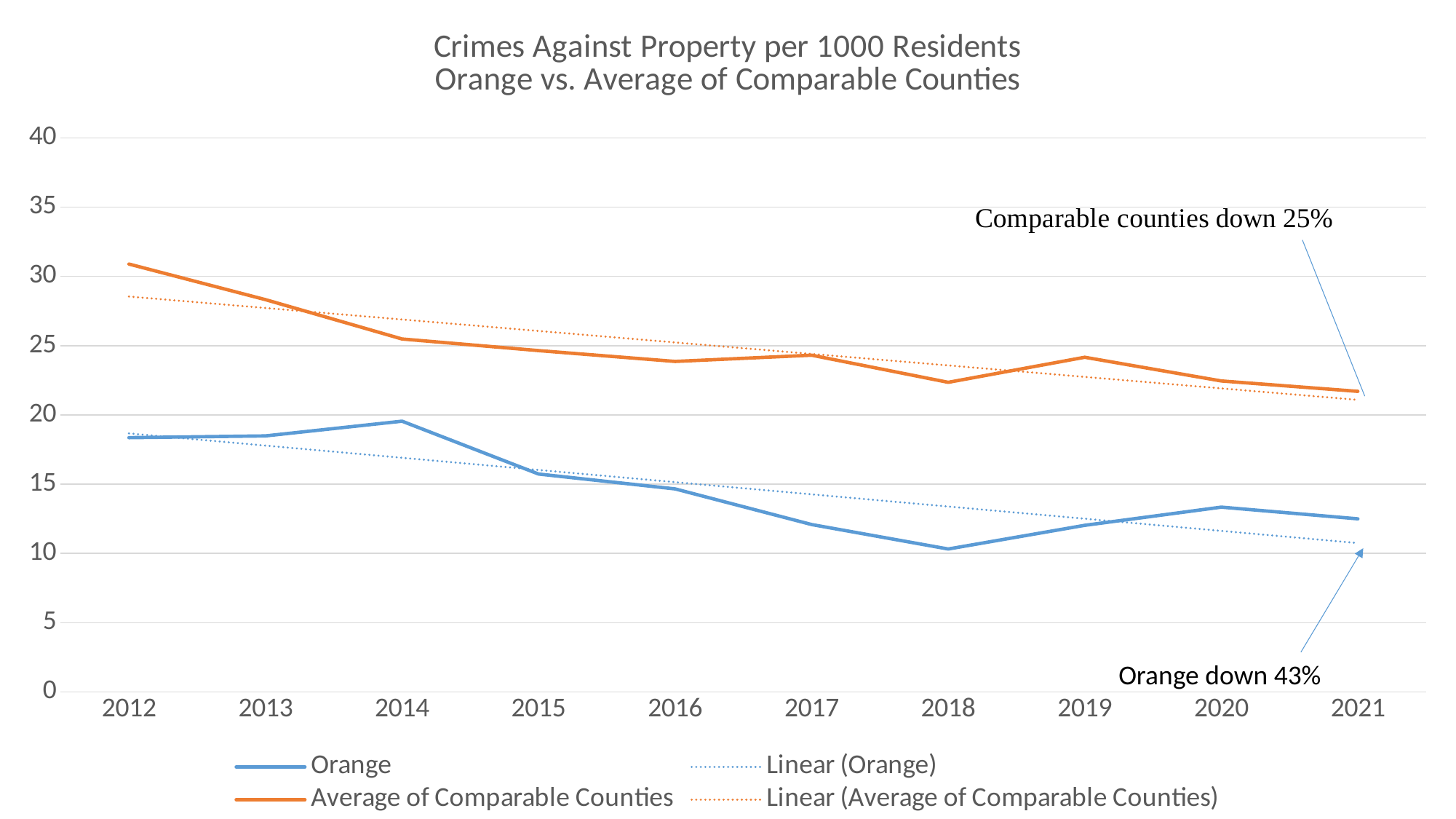
In which year is the Orange series at its lowest? 2018 Overall, do the Orange values rise or fall from 2012 to 2021? fall Is the value for Average of Comparable Counties in 2021 greater or less than 20? greater In which year is the Orange series at its highest? 2014 In which year is the Average of Comparable Counties series at its highest? 2012 How many years are shown along the x axis? 10 Which series is higher in 2021, Orange or Average of Comparable Counties? Average of Comparable Counties According to the annotation on the chart, by what percentage is Orange down? 43% How many series does the legend list? 4 What kind of chart is shown on the slide? line chart Is the value for Average of Comparable Counties in 2012 greater or less than 30? greater Is the value for Orange in 2018 greater or less than 15? less